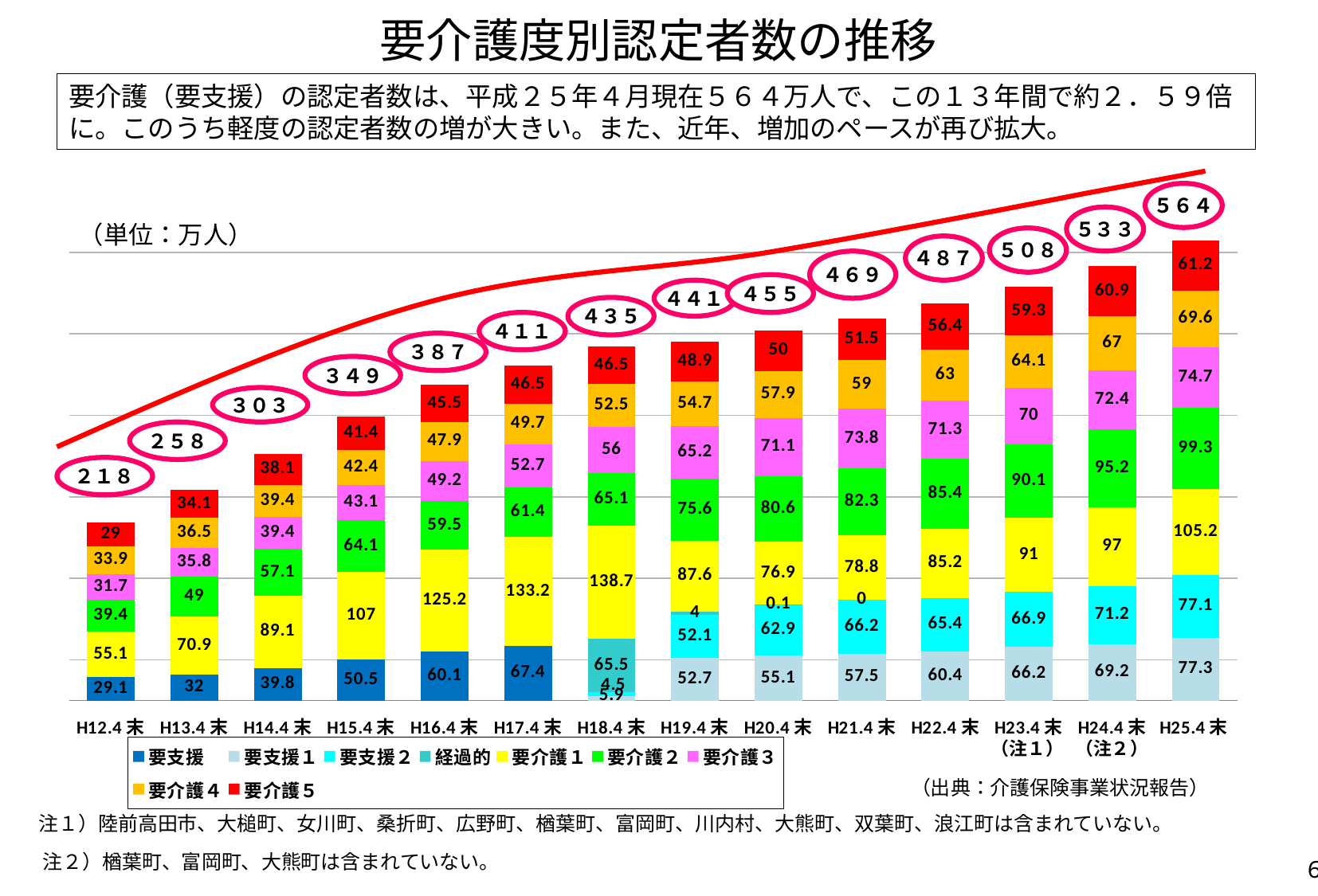
What is the value for 経過的 at H18.4末? 65.5 Which period has the highest total number of certified persons? H25.4末 What is the value for 要介護5 at H12.4末? 29 Which period has the lowest total number of certified persons? H12.4末 How many time periods (categories) are shown along the x axis? 14 What is the total of the stacked bar for H25.4末, as shown in the circled label? 564 What is the value for 要介護1 at H25.4末? 105.2 How many series does the legend list? 9 Do the total values rise or fall from H12.4末 to H25.4末? rise Which is larger: 要介護2 at H25.4末 or 要介護3 at H25.4末? 要介護2 at H25.4末 What kind of chart is shown on the slide? stacked bar chart What is the difference between the total for H25.4末 (564) and the total for H12.4末 (218)? 346